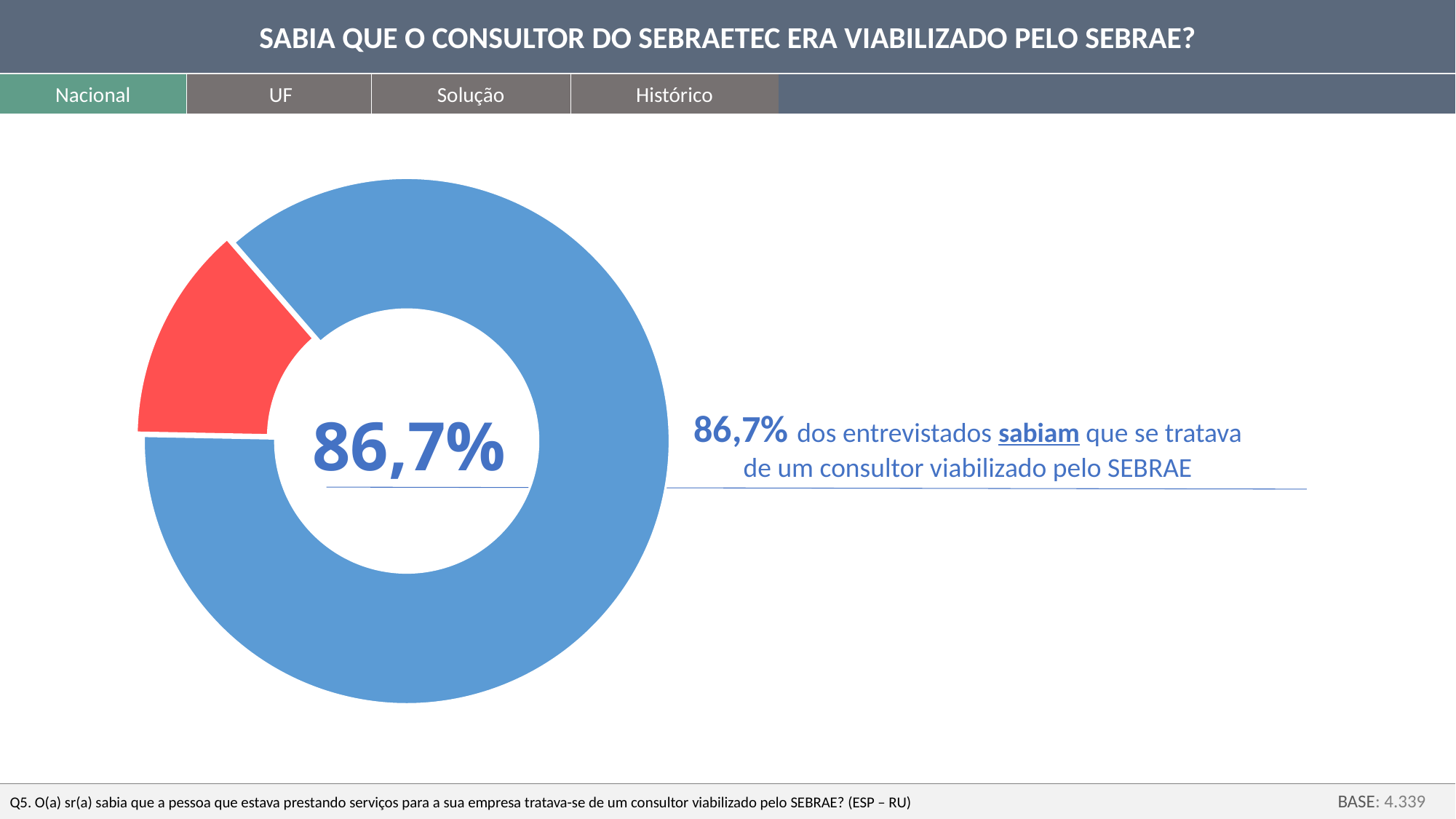
What value is printed in the centre of the donut chart? 86,7% Does the blue slice of the donut chart represent more or less than half of the respondents? More What kind of chart is shown on the slide? Donut (pie) chart What percentage of respondents knew (sabiam) that the consultant was made available by SEBRAE? 86,7% What is the title of the slide containing the chart? SABIA QUE O CONSULTOR DO SEBRAETEC ERA VIABILIZADO PELO SEBRAE? How many slices does the donut chart have? 2 What is the base (number of respondents) shown for the chart? 4.339 Which slice of the donut chart is larger, the blue one or the red one? The blue one Which colour represents the respondents who knew the consultant was made available by SEBRAE? Blue